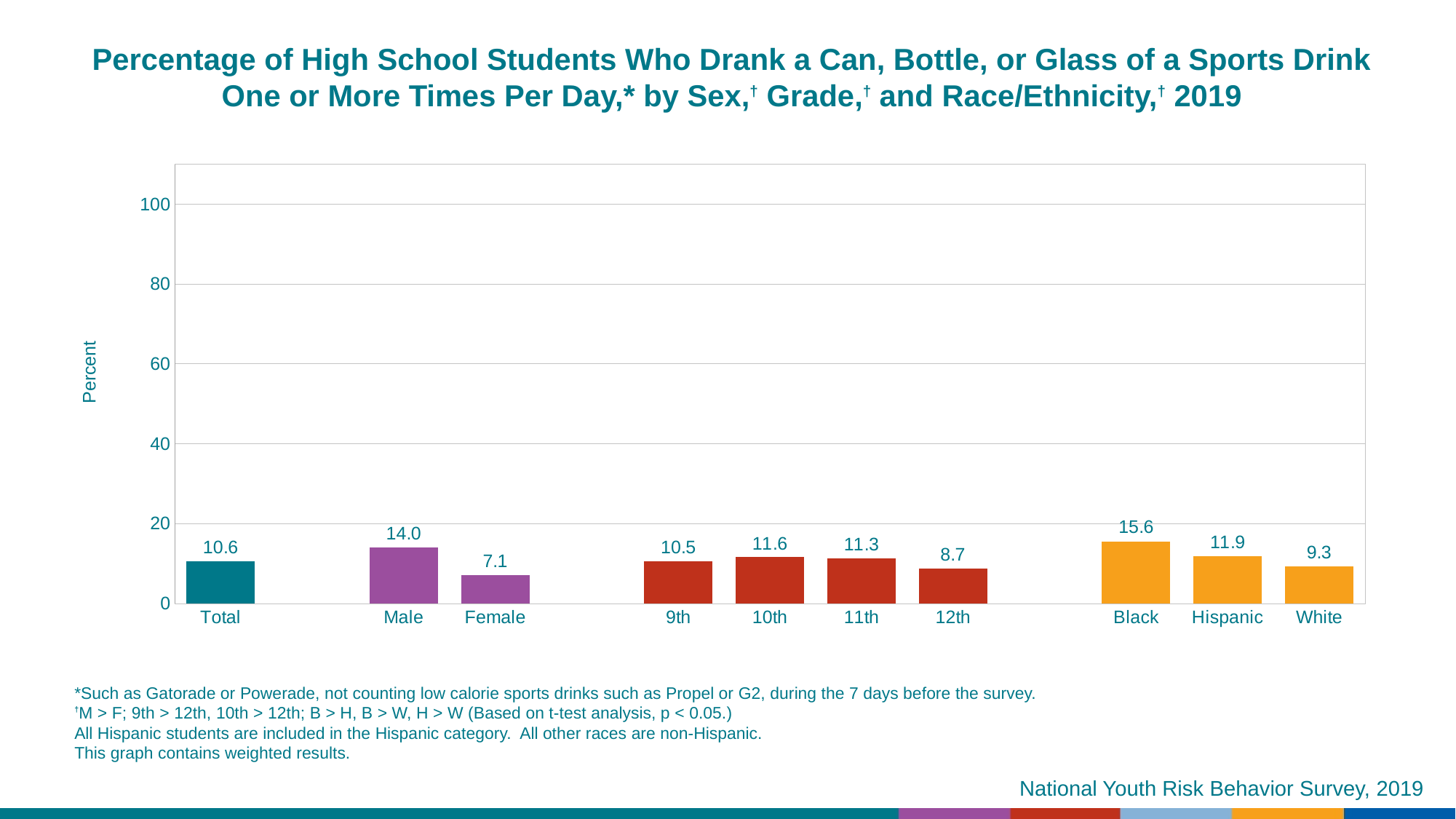
What is the value for 12th grade? 8.7 Is the value for Total greater or less than 20? less How many categories are shown on the x axis? 10 Which is larger, the value for 9th grade or 12th grade? 9th What is the value for Hispanic students? 11.9 What is the difference between the values for Black and White? 6.3 What is the value for Male? 14.0 Which category has the highest value? Black What kind of chart is this? bar chart What is the difference between the values for Male and Female? 6.9 Which category has the lowest value? Female What is the value for Female? 7.1